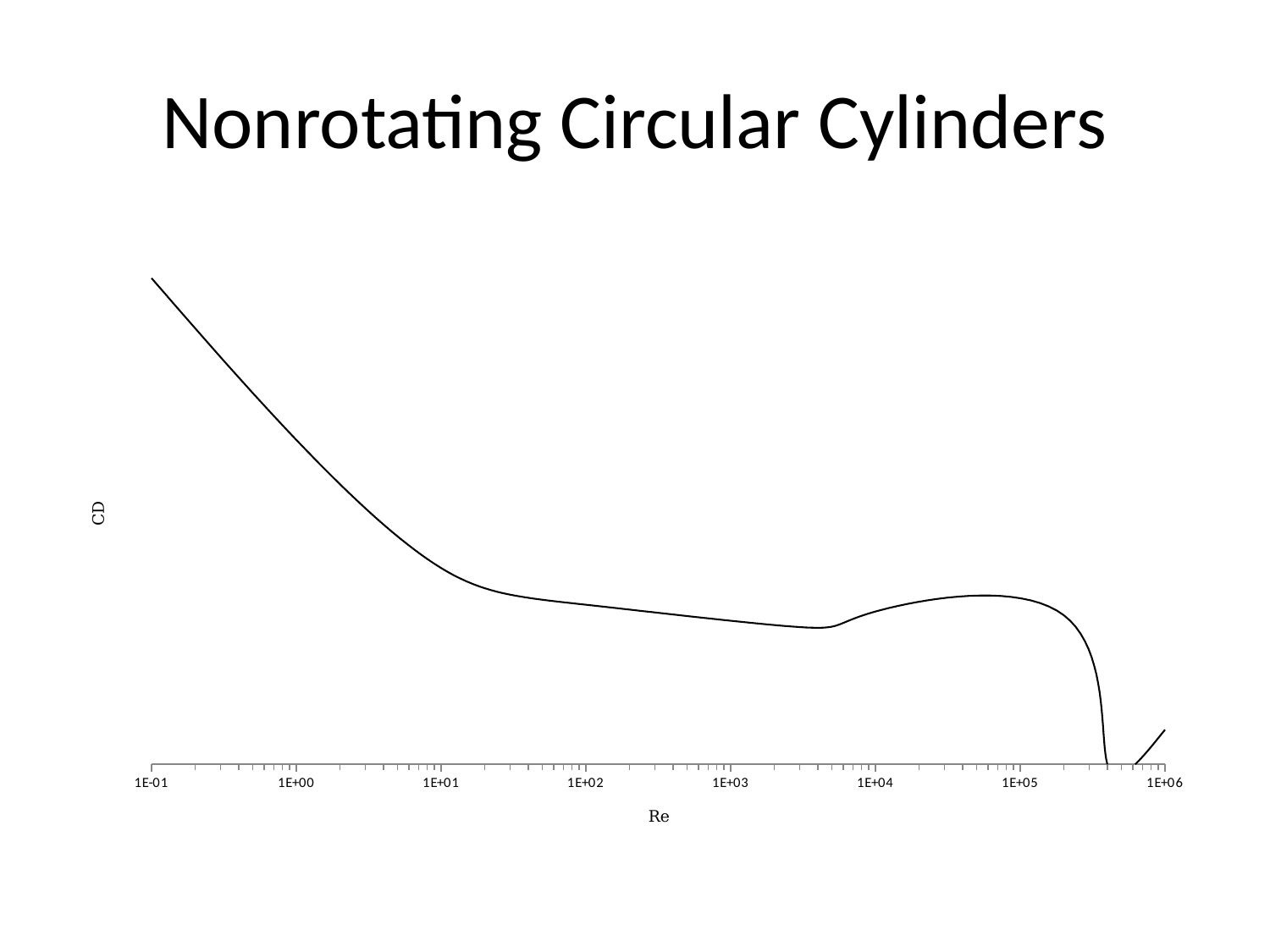
Is CD larger at Re = 1E-01 or at Re = 1E+03? 1E-01 What label is shown on the x axis of the chart? Re How many data series are plotted on the chart? 1 What is the leftmost labelled value on the x axis? 1E-01 Does CD rise or fall as Re increases from 1E+04 to 1E+05? rise Does CD rise or fall as Re increases from 1E-01 to 1E+01? fall What is the rightmost labelled value on the x axis? 1E+06 Does CD rise or fall as Re increases from 1E+05 to 1E+06? fall At which labelled Re value on the x axis is CD highest? 1E-01 How many labelled tick marks are shown on the x axis? 8 What kind of chart is shown on the slide? line chart What is the title of the chart? Nonrotating Circular Cylinders